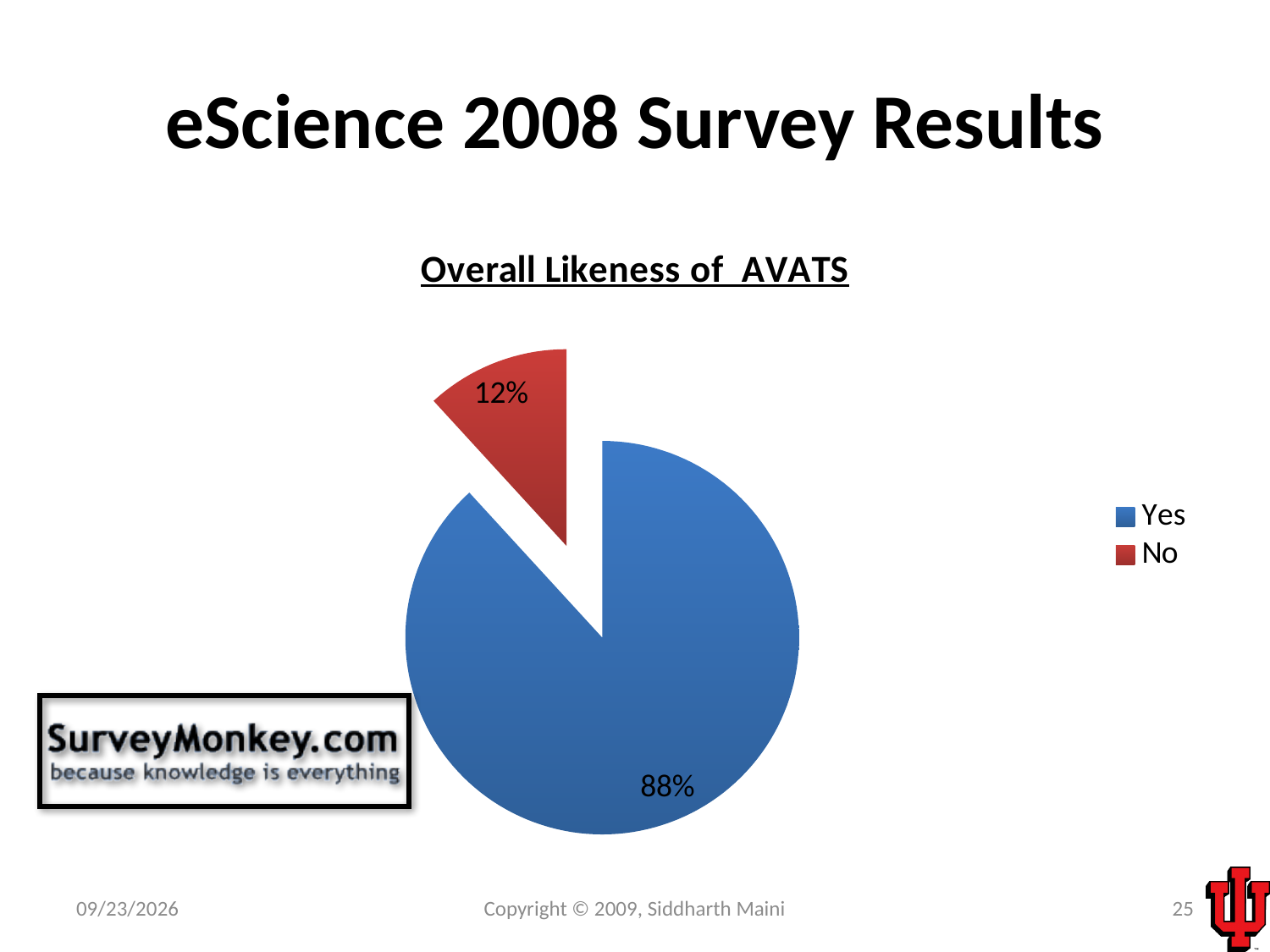
How many entries does the legend list? 2 What colour is the "No" slice in the pie chart? Red What share of the pie does the "Yes" slice represent? 88% How many categories does the pie chart show? 2 What is the difference in percentage points between the "Yes" and "No" slices? 76 What is the title of the chart? Overall Likeness of AVATS What kind of chart is shown on the slide? Pie chart Which category has the largest slice of the pie? Yes Which category has the smallest slice of the pie? No What share of the pie does the "No" slice represent? 12% Which is larger, the "Yes" slice or the "No" slice? Yes